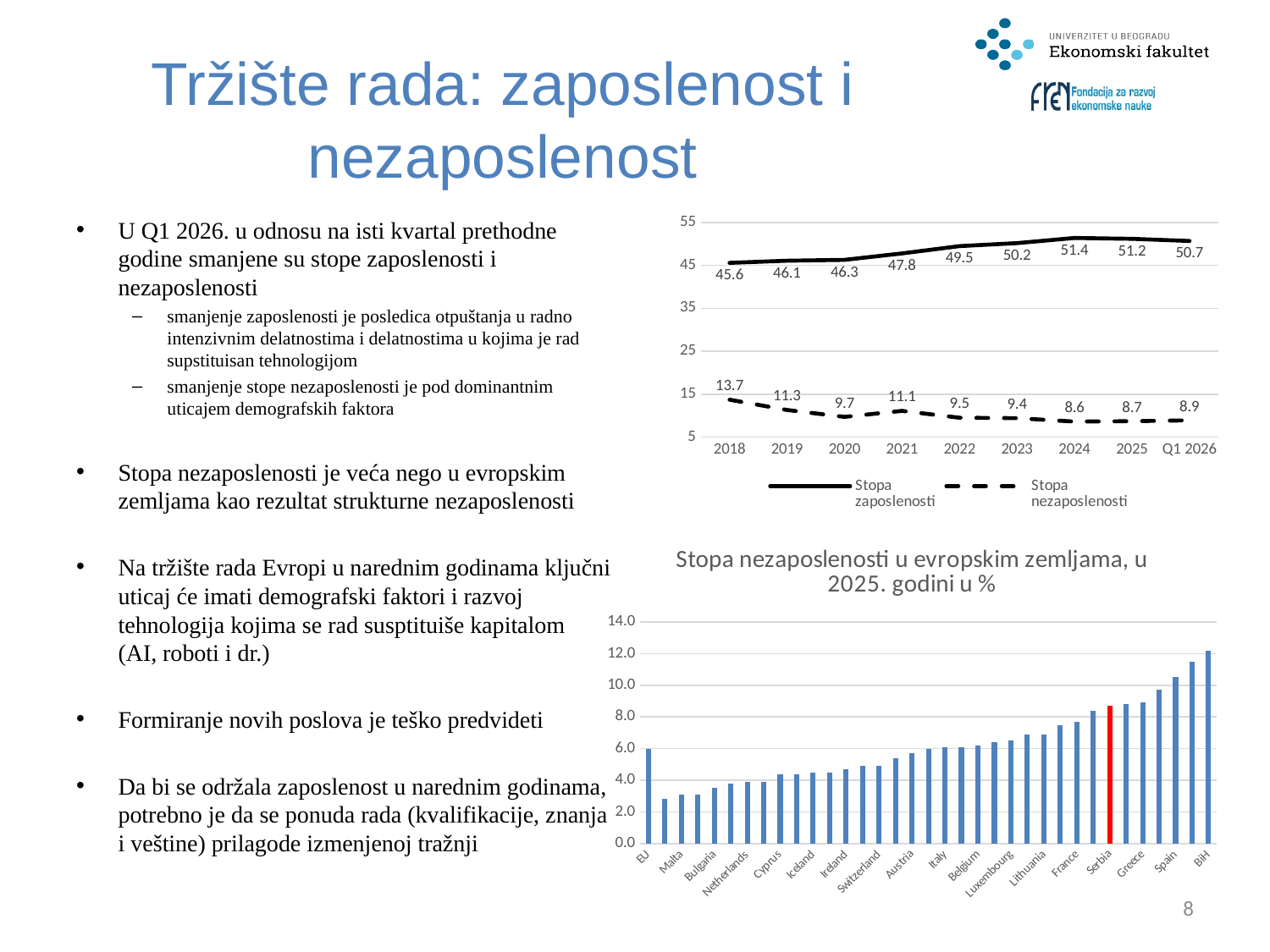
What kind of chart is the chart titled 'Stopa nezaposlenosti u evropskim zemljama, u 2025. godini u %'? bar chart In the top line chart, is Stopa nezaposlenosti higher in 2019 or in 2021? 2019 In the chart 'Stopa nezaposlenosti u evropskim zemljama, u 2025. godini u %', is the value for Serbia greater or less than 8.0? greater In the top line chart, how many time points are plotted on the x axis? 9 In the top line chart, how many series does the legend list? 2 In the chart 'Stopa nezaposlenosti u evropskim zemljama, u 2025. godini u %', which country has the highest value? BiH In the top line chart, does Stopa nezaposlenosti generally rise or fall from 2018 to 2024? fall In the top line chart, in which year is Stopa nezaposlenosti lowest? 2024 In the top line chart, what is the difference between Stopa zaposlenosti in 2024 and in 2018? 5.8 In the top line chart, what is the value of Stopa nezaposlenosti in Q1 2026? 8.9 In the top line chart, in which year is Stopa zaposlenosti highest? 2024 In the top line chart, what is the value of Stopa zaposlenosti in 2018? 45.6